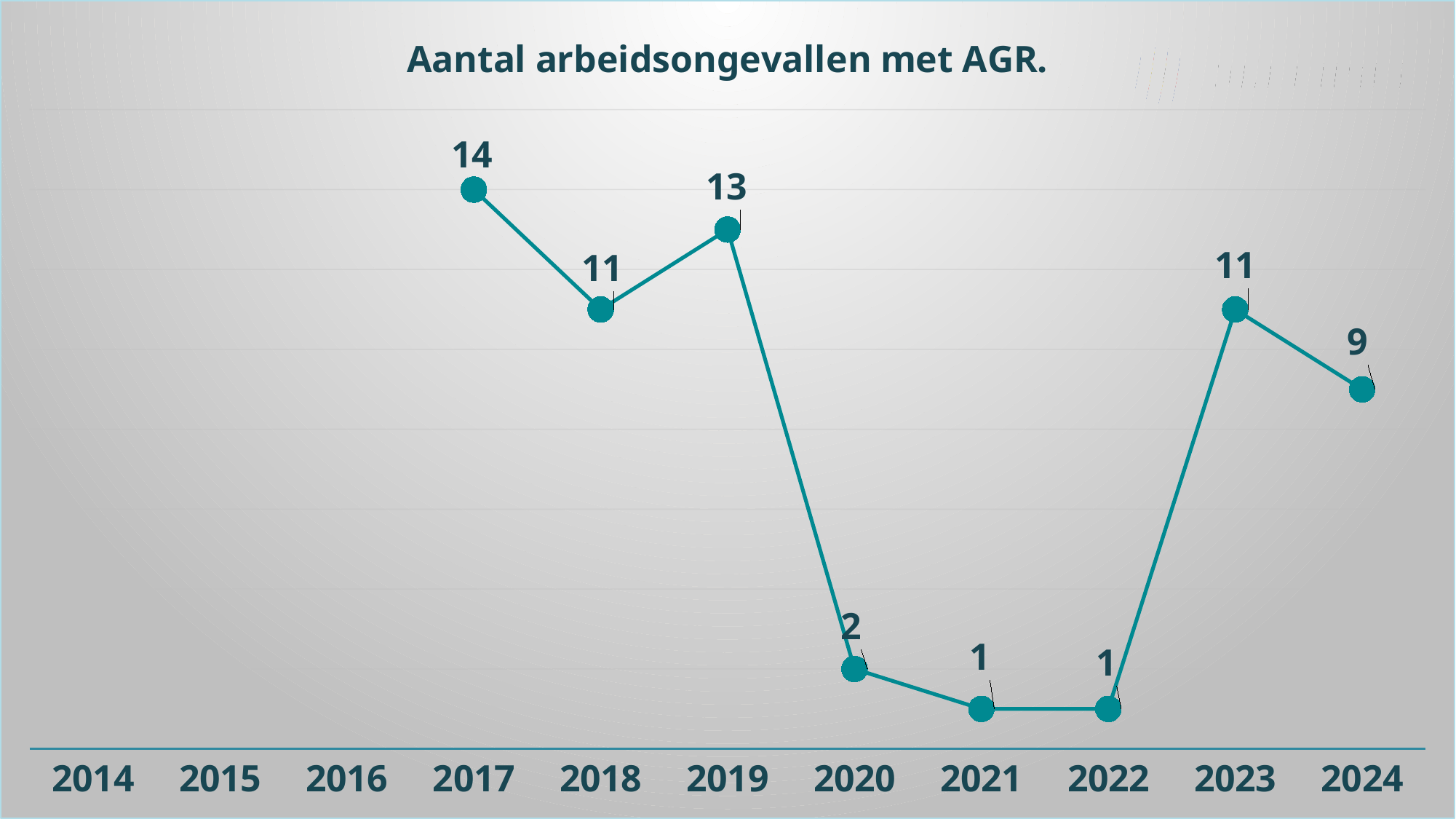
How many data points are plotted on the line? 8 Which year has the highest value? 2017 What is the lowest value plotted on the chart? 1 What is the value for 2024? 9 What is the value for 2017? 14 Which is larger, the value for 2018 or the value for 2019? 2019 What is the title of the chart? Aantal arbeidsongevallen met AGR. What is the difference between the values for 2019 and 2020? 11 What is the value for 2020? 2 What is the difference between the values for 2023 and 2024? 2 What is the value for 2019? 13 What kind of chart is this? line chart